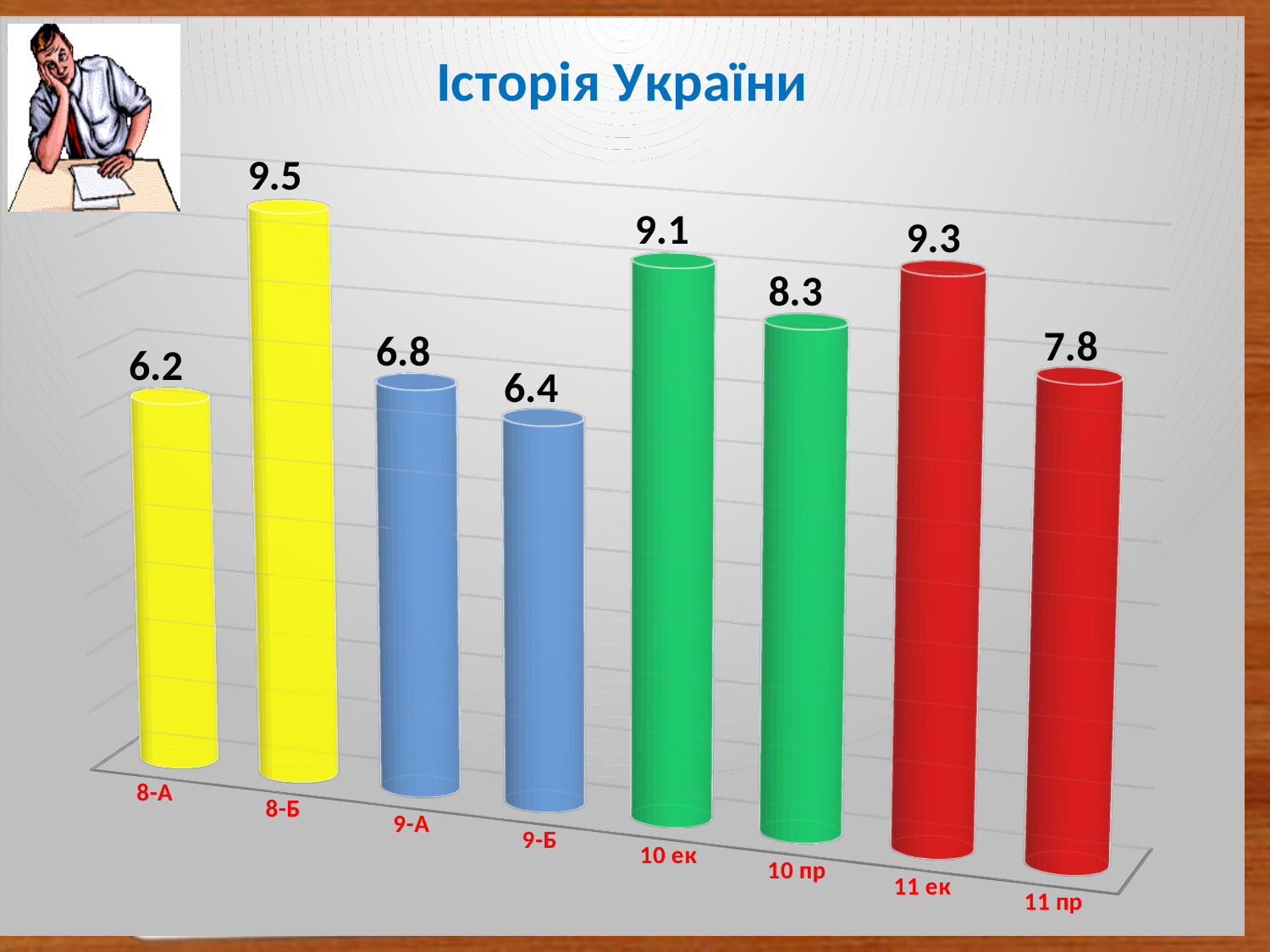
Which category has the lowest value? 8-А What is the difference between the values for 8-Б and 8-А? 3.3 Which is larger, the value for 10 ек or the value for 11 ек? 11 ек What kind of chart is shown on the slide? bar chart How many categories are shown in the chart? 8 What is the title of the chart? Історія України What is the value for 10 пр? 8.3 What is the value for 11 пр? 7.8 What is the difference between the values for 11 ек and 11 пр? 1.5 What is the value for 8-Б? 9.5 Which category has the highest value? 8-Б Which is larger, the value for 9-А or the value for 9-Б? 9-А